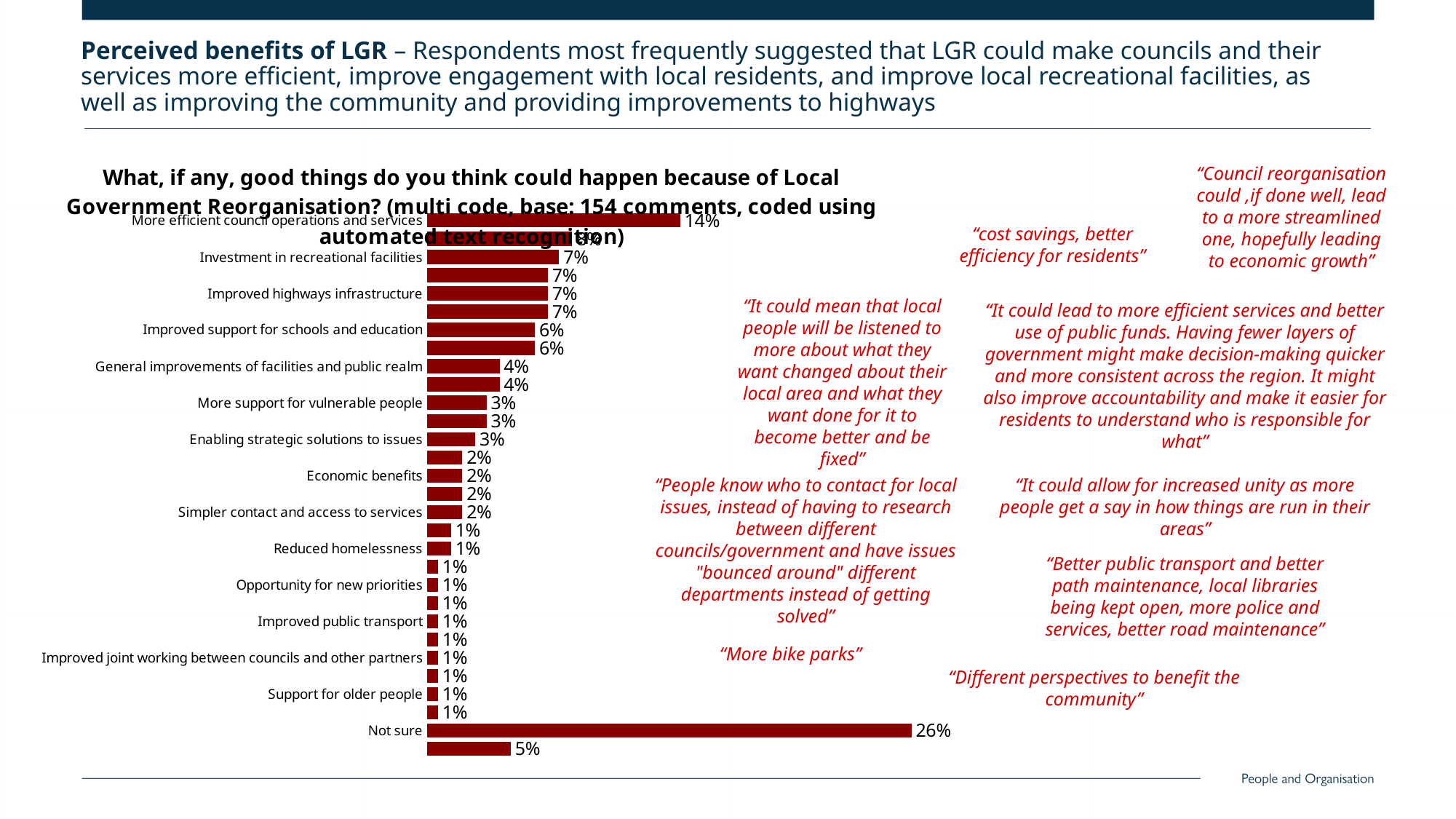
What is the value for 'Investment in recreational facilities'? 7% What is the difference between the value for 'Not sure' and the value for 'More efficient council operations and services'? 12% What is the value for 'Not sure'? 26% What is the value for 'Economic benefits'? 2% What is the value for 'General improvements of facilities and public realm'? 4% What is the value for 'Support for older people'? 1% What kind of chart is shown on the slide? Bar chart What is the value for 'Improved support for schools and education'? 6% Which is larger: the value for 'More support for vulnerable people' or the value for 'Improved highways infrastructure'? Improved highways infrastructure Which category has the highest value in the chart? Not sure What percentage of comments mentioned 'More efficient council operations and services'? 14% What colour are the bars in the chart? Dark red